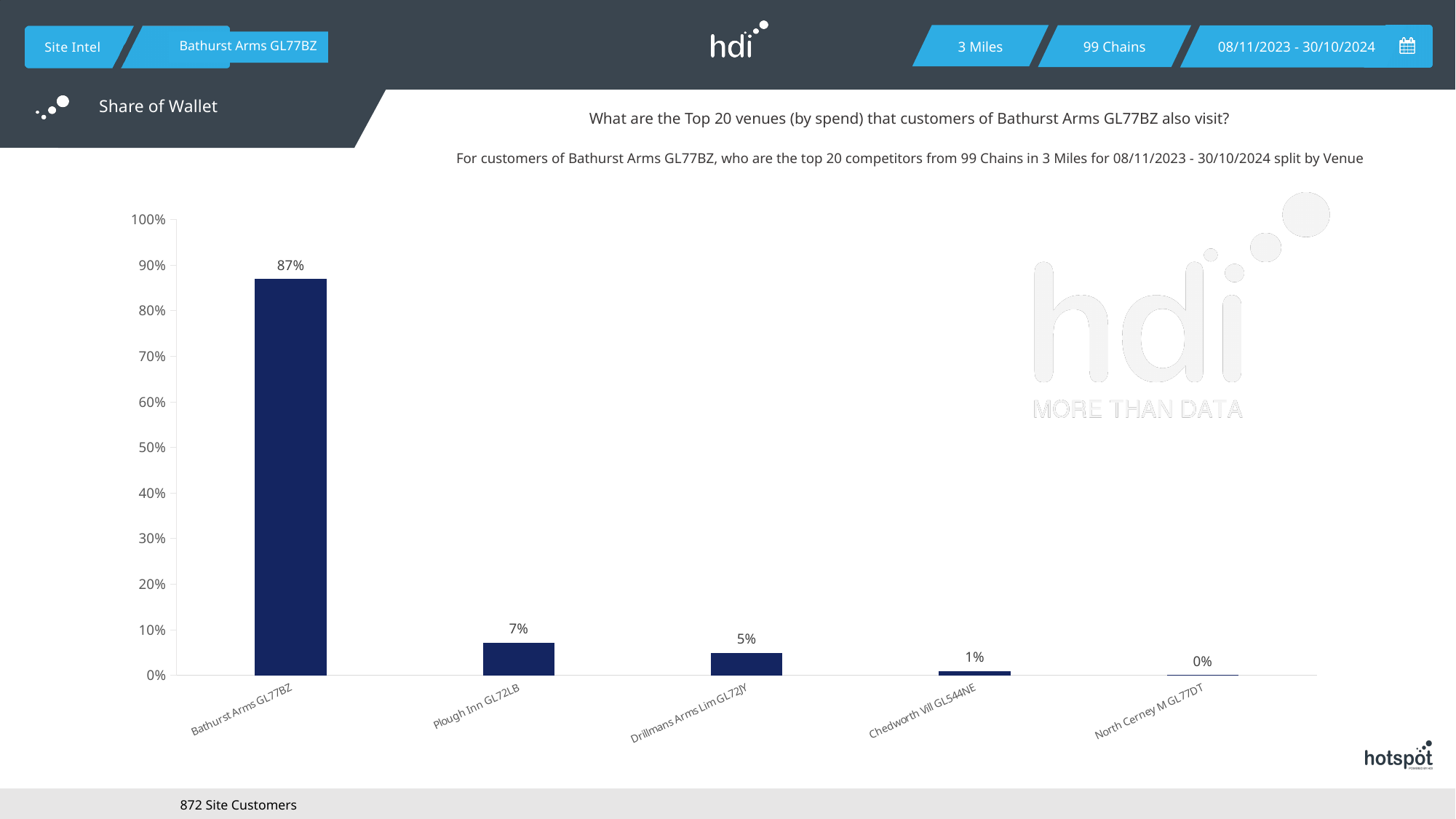
What is the value for Chedworth Vill GL544NE? 1% What is the value for Plough Inn GL72LB? 7% Do the values rise or fall from left to right along the x axis? Fall What is the value for Drillmans Arms Lim GL72JY? 5% How many venues are shown on the chart? 5 Which venue has the highest value? Bathurst Arms GL77BZ What is the difference between the values for Bathurst Arms GL77BZ and Plough Inn GL72LB? 80% Which is larger, the value for Plough Inn GL72LB or Drillmans Arms Lim GL72JY? Plough Inn GL72LB What is the value for North Cerney M GL77DT? 0% Which venue has the lowest value? North Cerney M GL77DT What is the value for Bathurst Arms GL77BZ? 87% What kind of chart is shown on the slide? Bar chart